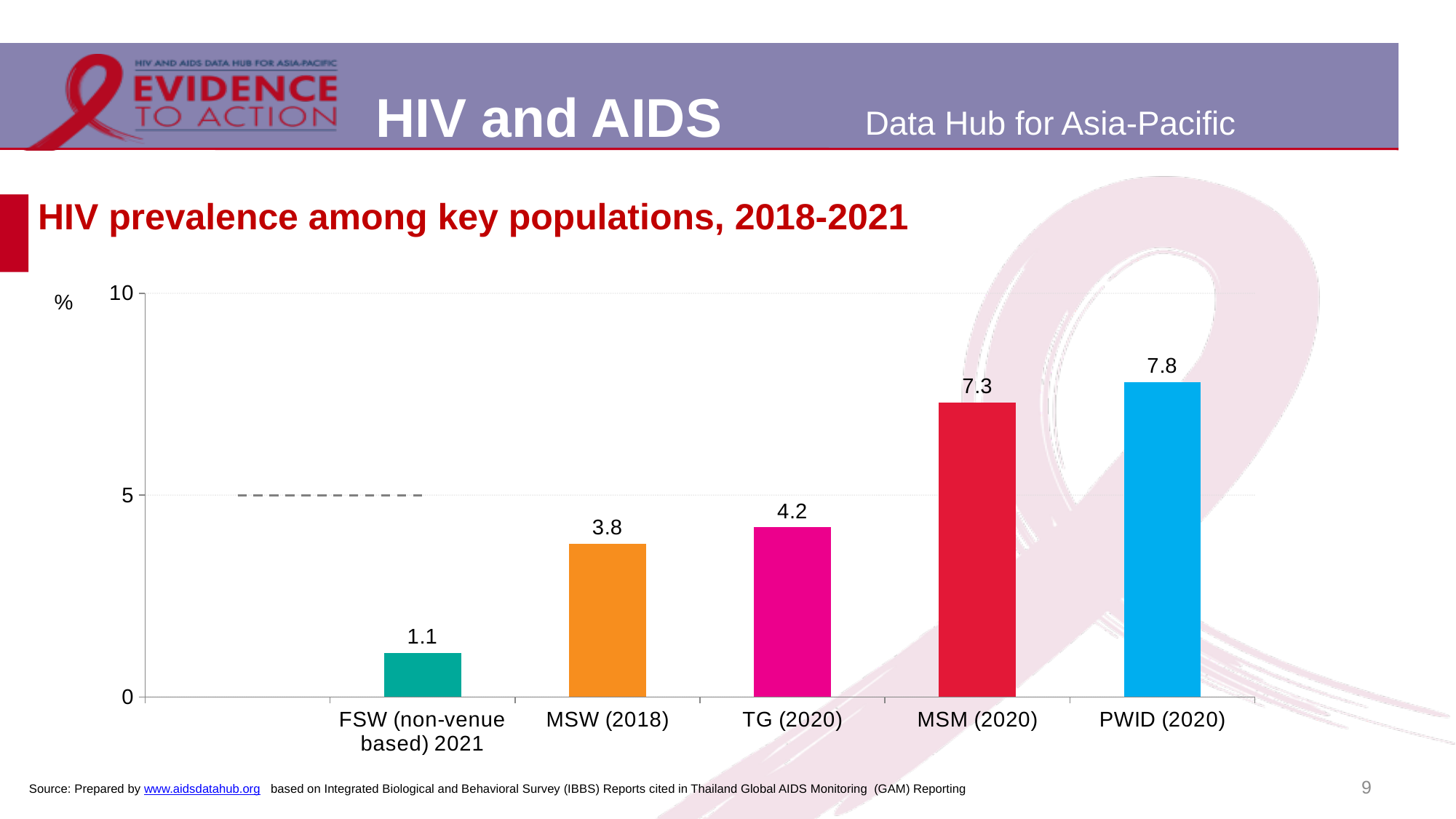
How many key population categories are shown on the chart? 5 What is the difference between the HIV prevalence values for PWID (2020) and MSM (2020)? 0.5 What is the HIV prevalence value shown for PWID (2020)? 7.8 What is the HIV prevalence value shown for FSW (non-venue based) 2021? 1.1 What is the difference between the HIV prevalence values for TG (2020) and FSW (non-venue based) 2021? 3.1 Which key population has the highest HIV prevalence on the chart? PWID (2020) Which key population has the lowest HIV prevalence on the chart? FSW (non-venue based) 2021 Which has a higher HIV prevalence value, MSM (2020) or TG (2020)? MSM (2020) What kind of chart is shown on the slide? Bar chart Is the value for MSW (2018) greater or less than 5? less What is the HIV prevalence value shown for TG (2020)? 4.2 What is the HIV prevalence value shown for MSW (2018)? 3.8